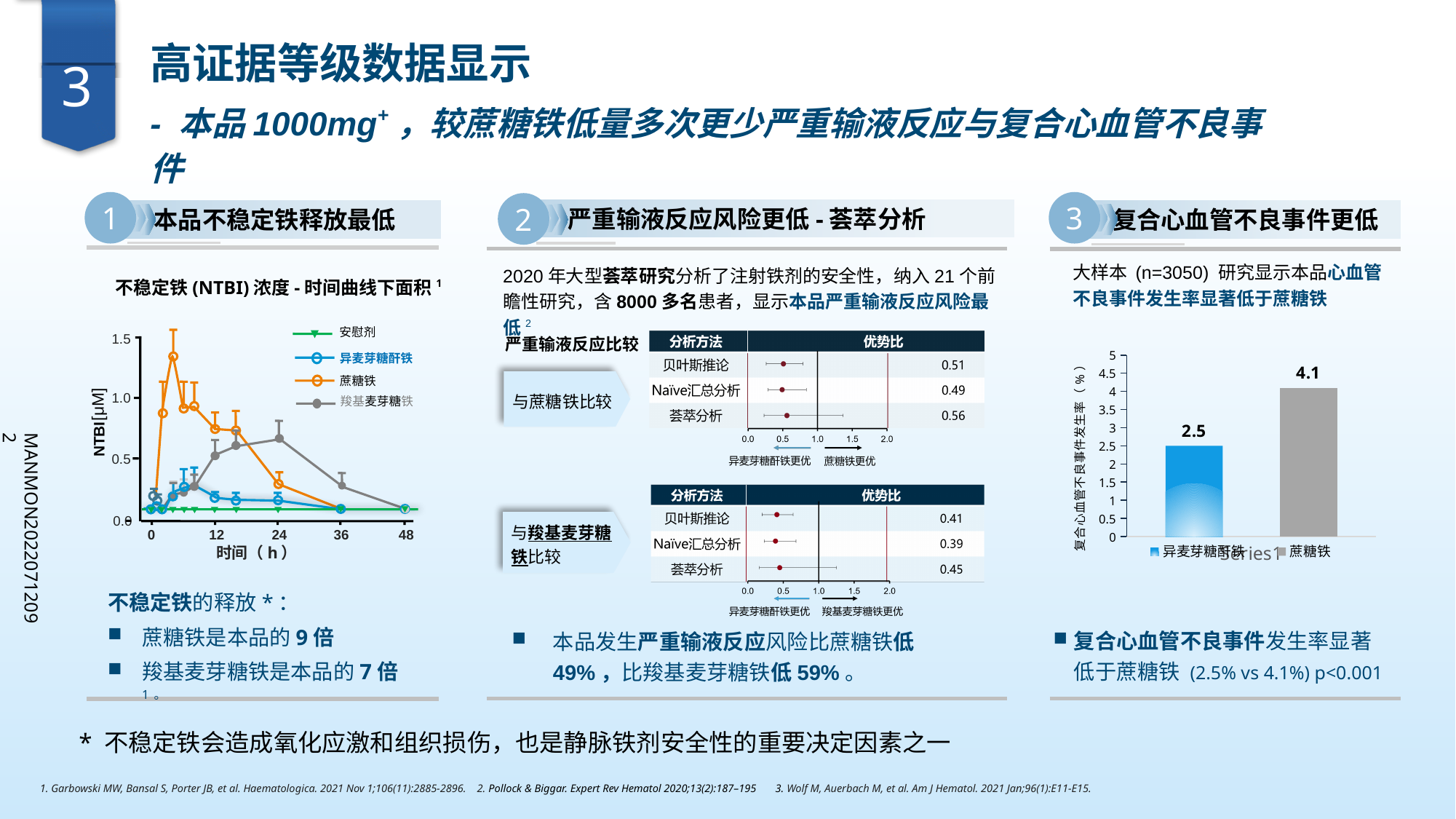
In the forest plot 与羧基麦芽糖铁比较, which analysis method has the highest 优势比? 荟萃分析 In the bar chart on the right (复合心血管不良事件), what is the value for 异麦芽糖酐铁? 2.5 In the bar chart on the right, which category has the higher value, 异麦芽糖酐铁 or 蔗糖铁? 蔗糖铁 In the NTBI concentration-time line chart, is the peak value for 蔗糖铁 greater or less than 1.0? greater What kind of chart is the chart on the right showing 复合心血管不良事件发生率? bar chart How many series does the legend of the NTBI concentration-time line chart list? 4 In the bar chart on the right (复合心血管不良事件), what is the value for 蔗糖铁? 4.1 In the bar chart on the right, what is the difference between the values for 蔗糖铁 and 异麦芽糖酐铁? 1.6 In the forest plot 与蔗糖铁比较, what is the 优势比 for 荟萃分析? 0.56 In the forest plot 与蔗糖铁比较, which analysis method has the lowest 优势比? Naïve汇总分析 In the forest plot 与羧基麦芽糖铁比较, what is the 优势比 for 贝叶斯推论? 0.41 In the bar chart on the right, how many bars are plotted? 2